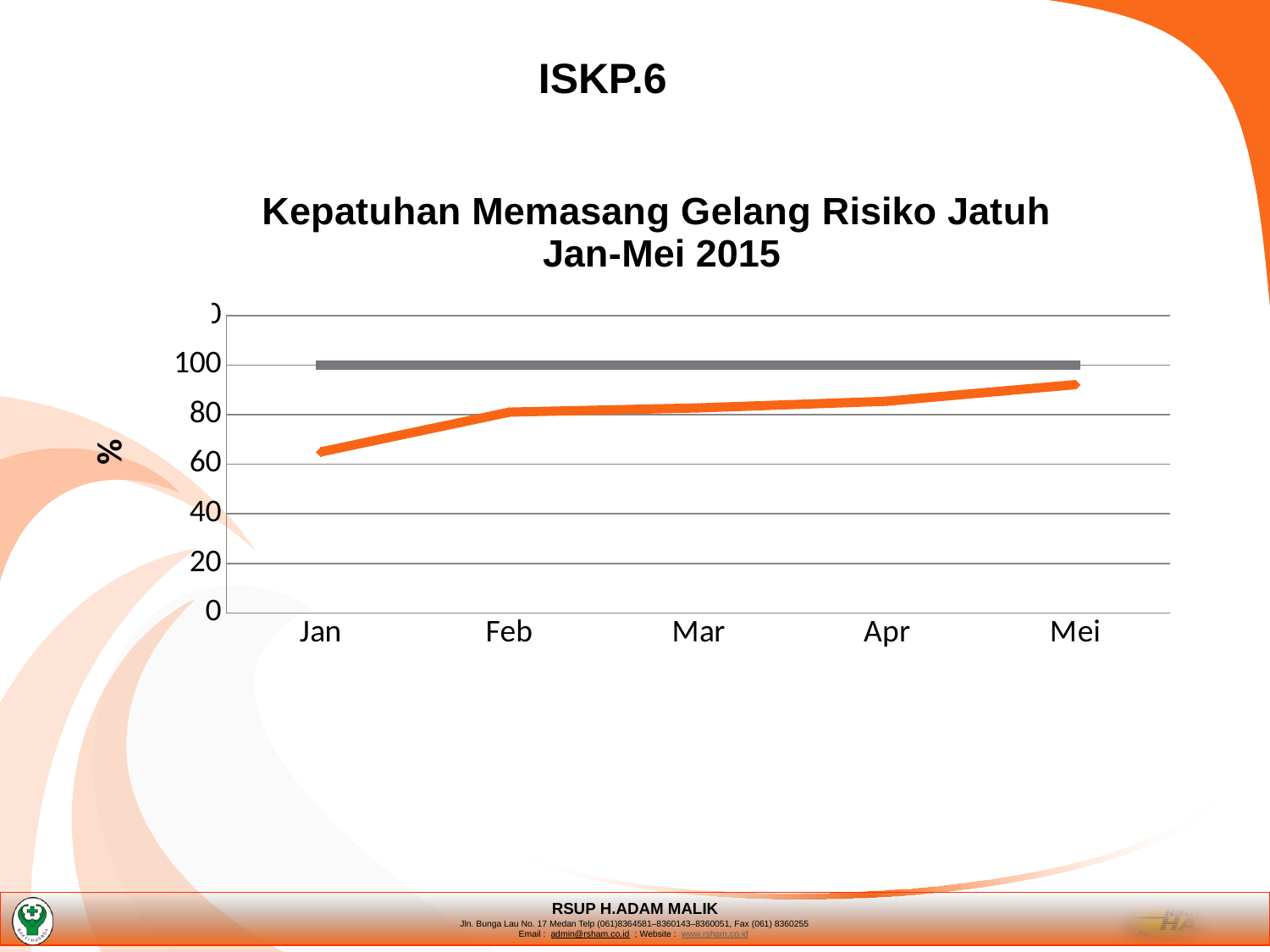
Which month has the larger value on the orange line, Jan or Mei? Mei In which month is the orange line at its highest value? Mei At what value on the vertical axis does the flat gray line sit? 100 What is the title of the chart? Kepatuhan Memasang Gelang Risiko Jatuh Jan-Mei 2015 Is the value of the orange line for Mei greater or less than 100? less Does the orange line rise or fall from Jan to Mei? rise What kind of chart is shown on the slide? line chart How many months are shown on the x axis of the chart? 5 In which month is the orange line at its lowest value? Jan Is the value of the orange line for Jan greater or less than 80? less What is the label on the vertical axis of the chart? % Is the value of the orange line for Mei greater or less than 80? greater